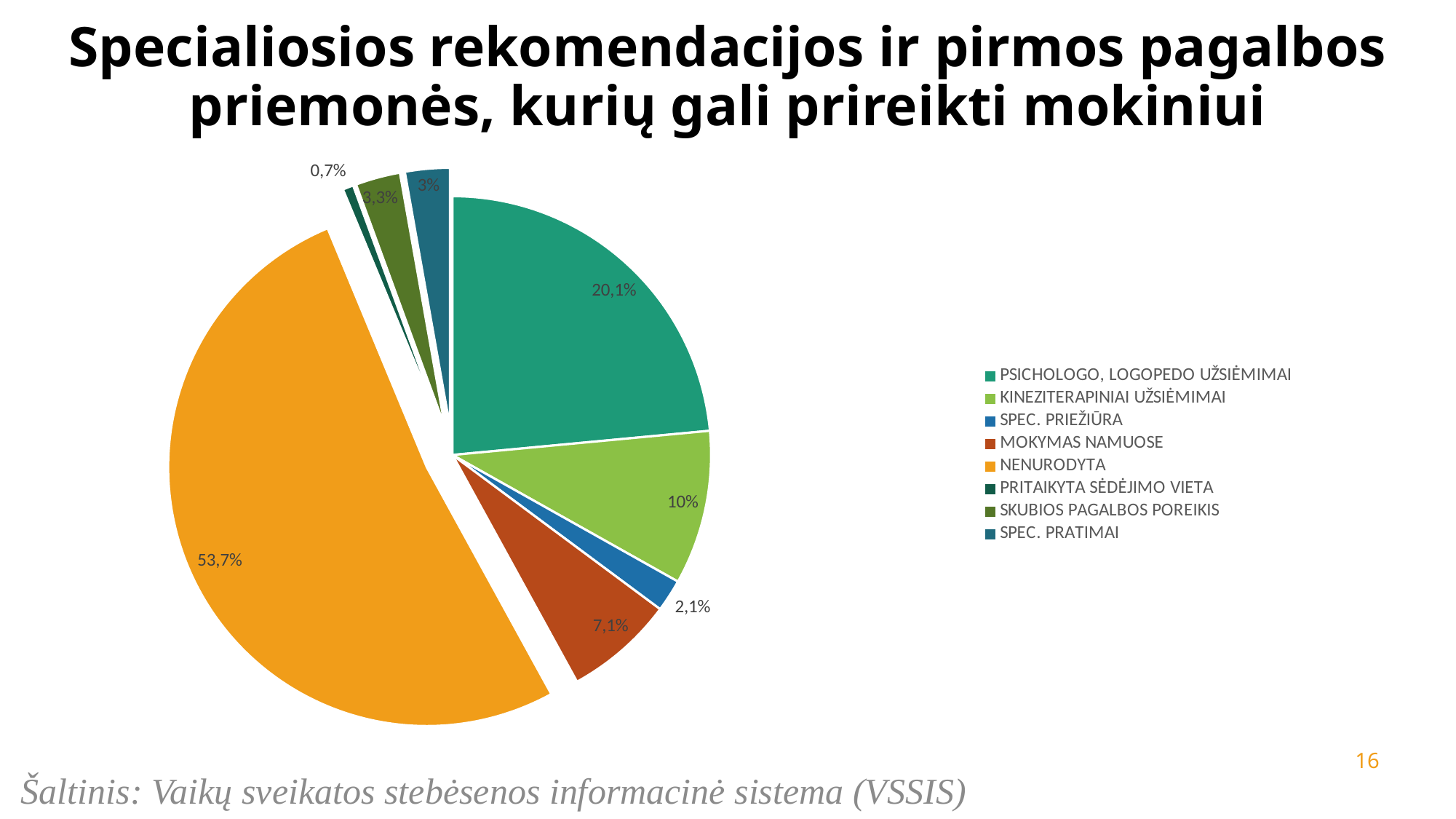
What is the value for PSICHOLOGO, LOGOPEDO UŽSIĖMIMAI? 20,1% What is the value for KINEZITERAPINIAI UŽSIĖMIMAI? 10% What share of the pie does NENURODYTA have? 53,7% What colour is the slice for NENURODYTA? Orange What is the value for SPEC. PRIEŽIŪRA? 2,1% Which is larger, SKUBIOS PAGALBOS POREIKIS or SPEC. PRATIMAI? SKUBIOS PAGALBOS POREIKIS What type of chart is shown on the slide? Pie chart What is the value for MOKYMAS NAMUOSE? 7,1% Which category has the smallest slice of the pie? PRITAIKYTA SĖDĖJIMO VIETA How many categories does the legend list? 8 Which category has the largest slice of the pie? NENURODYTA What is the difference between the values for PSICHOLOGO, LOGOPEDO UŽSIĖMIMAI and KINEZITERAPINIAI UŽSIĖMIMAI? 10,1%